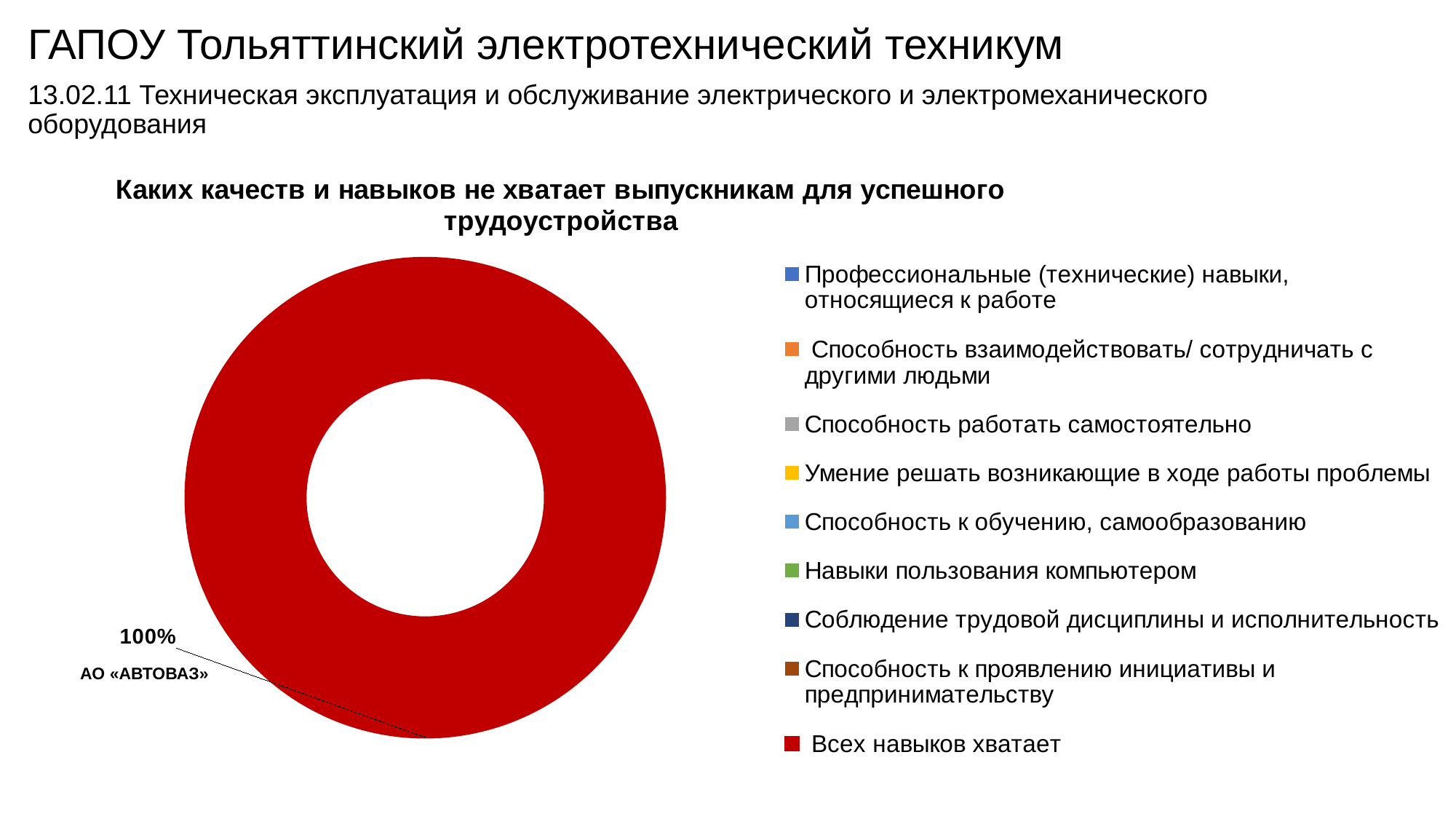
What is the share for 'Всех навыков хватает'? 100% How many entries does the chart legend list? 9 Is the share for 'Всех навыков хватает' greater or less than 50%? greater What value is printed as the data label on the chart? 100% What kind of chart is shown on the slide? Doughnut (pie) chart How many slices are visibly plotted in the doughnut chart? 1 Which legend category does the only visible slice of the chart correspond to? Всех навыков хватает What share of the doughnut chart does the red slice take? 100% What is the title of the chart? Каких качеств и навыков не хватает выпускникам для успешного трудоустройства Which employer name is printed next to the 100% data label? АО «АВТОВАЗ» What colour is the slice that fills the doughnut chart? Red Which category has the highest share in the chart? Всех навыков хватает